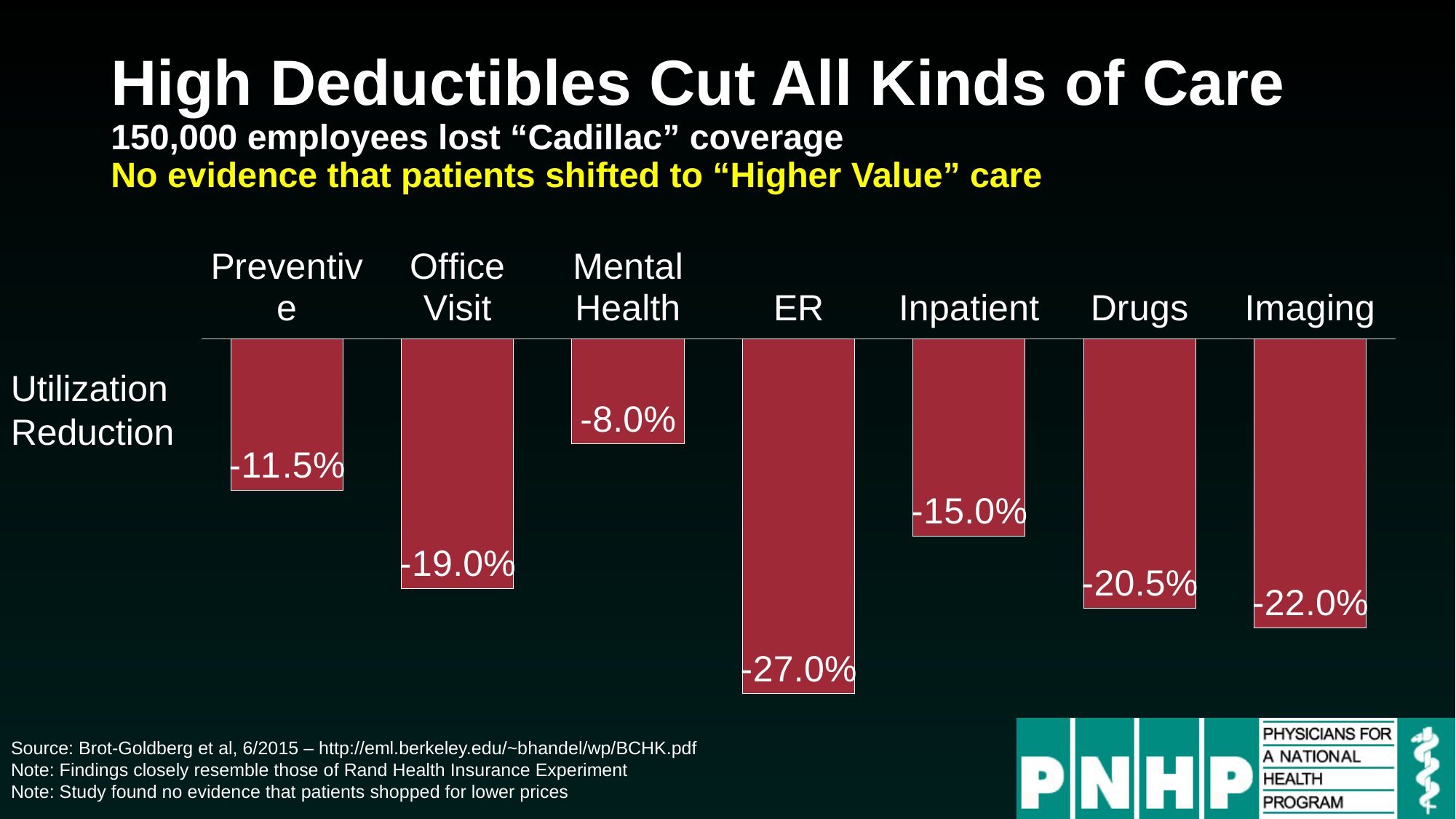
How many percentage points larger is the utilization reduction for ER than for Inpatient? 12.0 percentage points What is the utilization reduction for ER? -27.0% What is the utilization reduction for Mental Health? -8.0% What is the utilization reduction for Drugs? -20.5% What is the difference between the utilization reductions for Imaging and Drugs? 1.5 percentage points What kind of chart is shown on the slide? Bar chart Which has a larger utilization reduction, Office Visit or Inpatient? Office Visit How many categories of care are shown in the chart? 7 Which category shows the largest utilization reduction? ER What is the utilization reduction for Preventive care? -11.5% Which category shows the smallest utilization reduction? Mental Health What is the title of the slide containing the chart? High Deductibles Cut All Kinds of Care